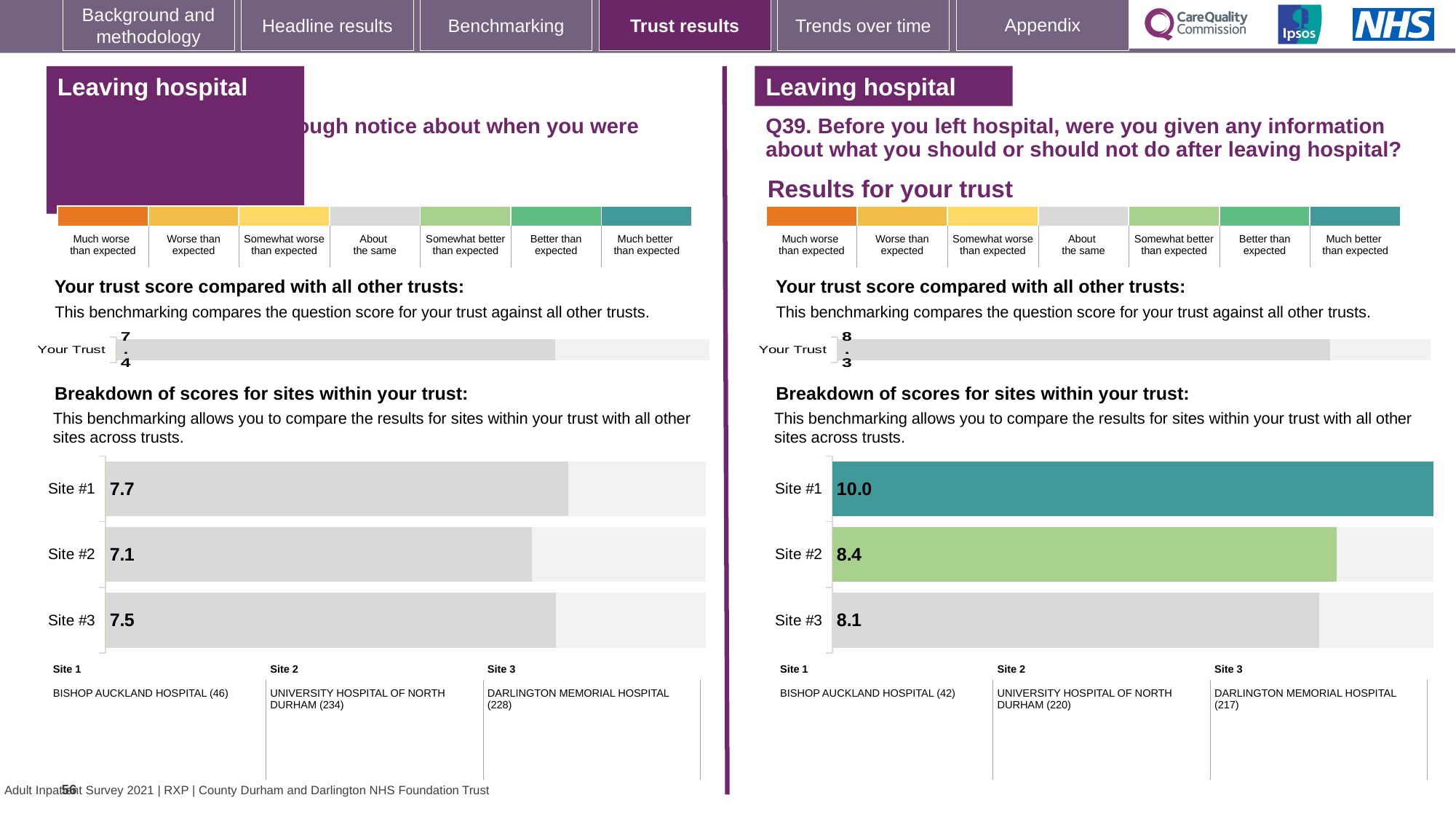
On the right-hand (Q39) site breakdown chart, what is the difference between the scores for Site #1 and Site #2? 1.6 On the left-hand site breakdown chart, what is the score for Site #2? 7.1 On the left-hand site breakdown chart, which site has the lowest score? Site #2 On the right-hand (Q39) site breakdown chart, which site has the lowest score? Site #3 On the left-hand site breakdown chart, which is larger: the score for Site #2 or Site #3? Site #3 What type of chart is used for the site breakdown on the right-hand (Q39) side? Bar chart On the right-hand (Q39) site breakdown chart, what is the score for Site #3? 8.1 On the left-hand site breakdown chart, which site has the highest score? Site #1 On the right-hand (Q39) 'Your trust score compared with all other trusts' chart, what is the value for Your Trust? 8.3 How many sites are shown on the right-hand (Q39) site breakdown chart? 3 On the right-hand (Q39) site breakdown chart, what is the score for Site #1? 10.0 On the left-hand site breakdown chart, what is the difference between the scores for Site #1 and Site #3? 0.2